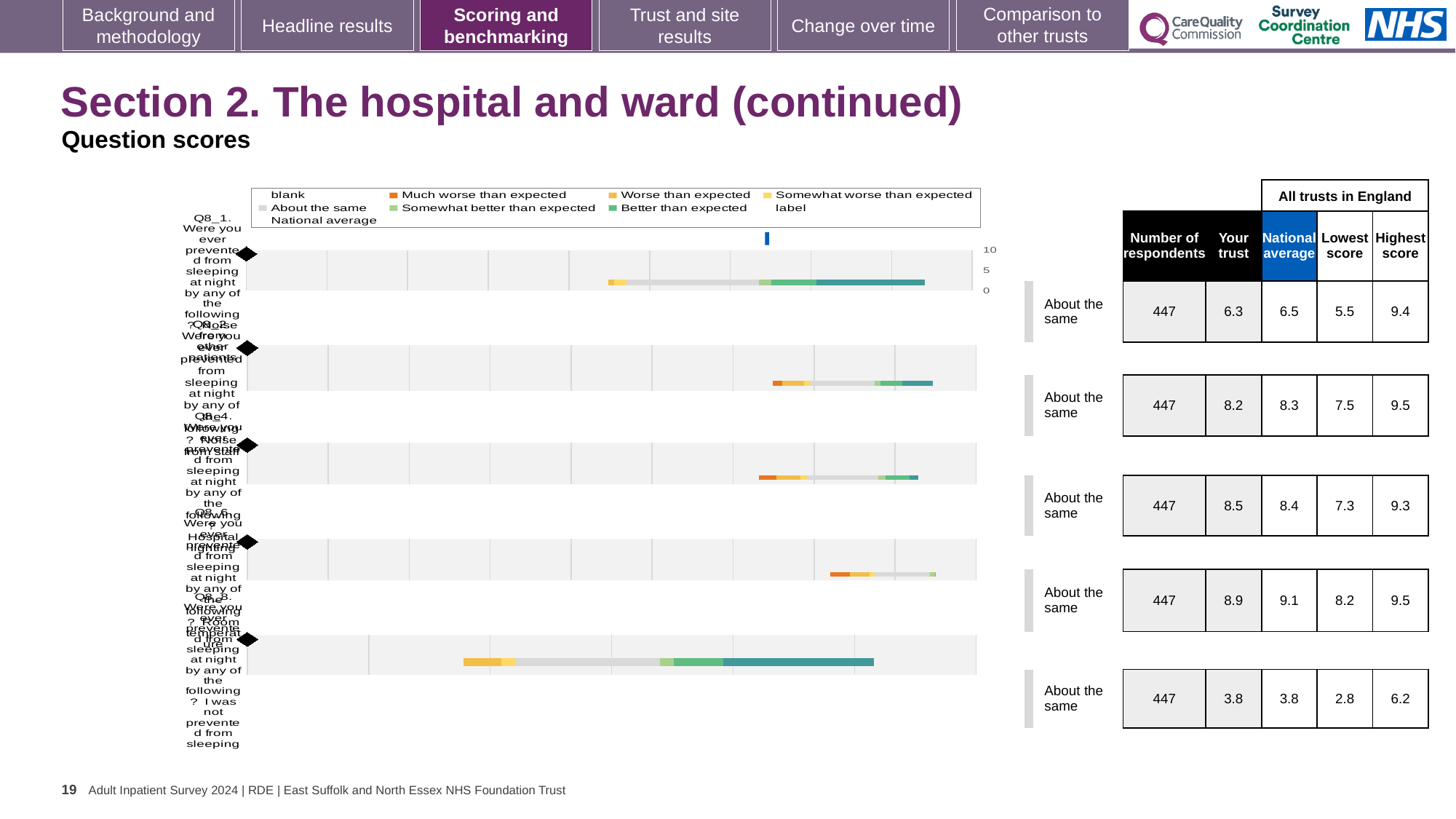
Which legend entry is shown in orange? Much worse than expected What benchmark label is shown next to every bar in the chart? About the same How many entries does the chart legend list? 9 What kind of chart is shown on the slide? bar chart What is the difference between the 'Your trust' score and the national average for Q8_4? 0.1 What is the national average score for Q8_2? 8.3 Which question has the lowest 'Your trust' score? Q8_8 What is the highest score across all trusts in England for Q8_8? 6.2 What is the 'Your trust' score for Q8_1? 6.3 How many question rows (bars) does the chart show? 5 Which question has the highest 'Your trust' score? Q8_6 For Q8_1, which is larger: the 'Your trust' score or the national average? National average